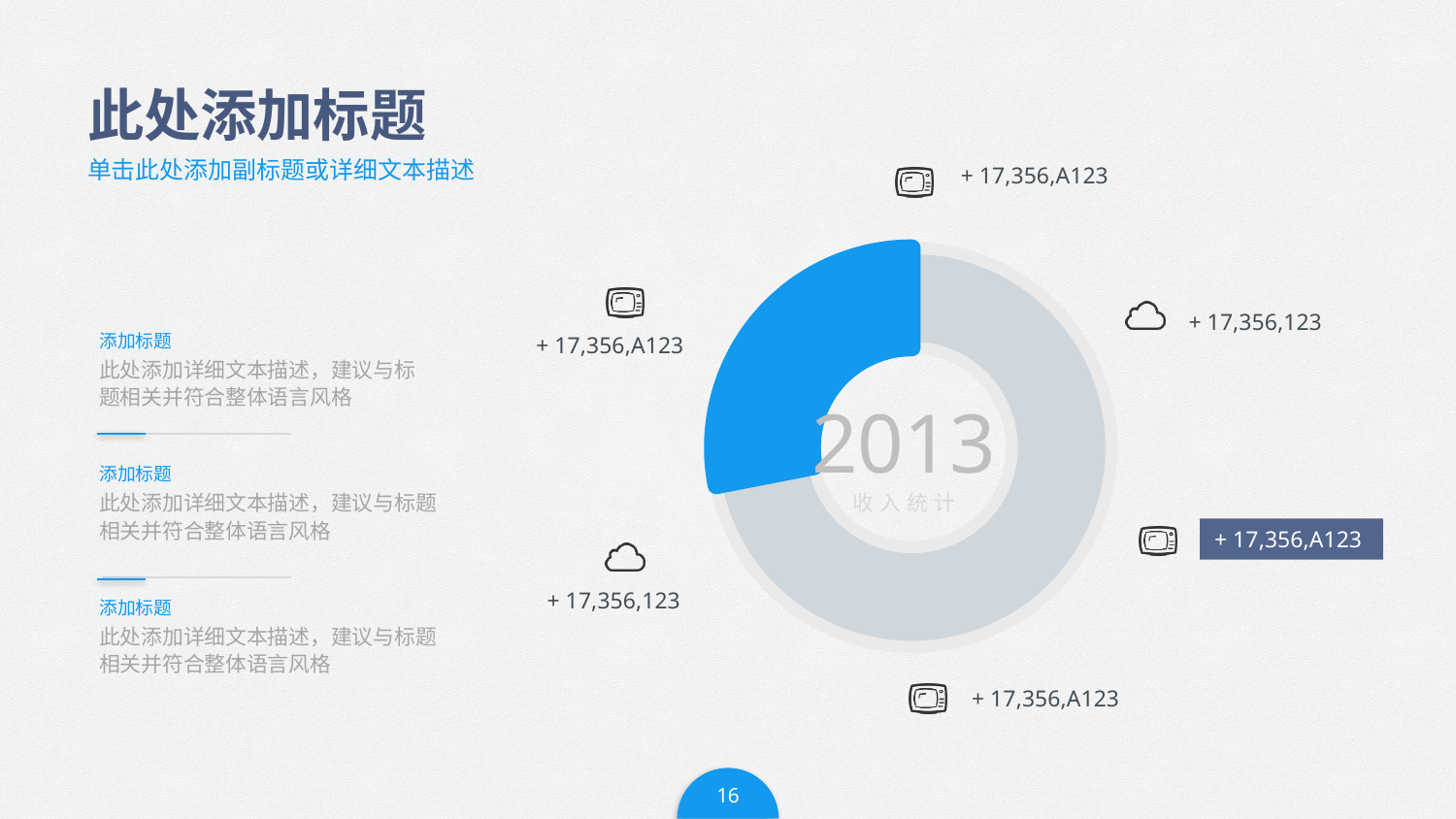
What kind of chart is shown on the slide? Donut chart Which segment of the donut chart is the smallest? The blue segment How many segments does the donut chart have? 2 Which segment of the donut chart is larger, the blue one or the grey one? The grey one What year is printed in the centre of the donut chart? 2013 What text appears below the year in the centre of the donut chart? 收入统计